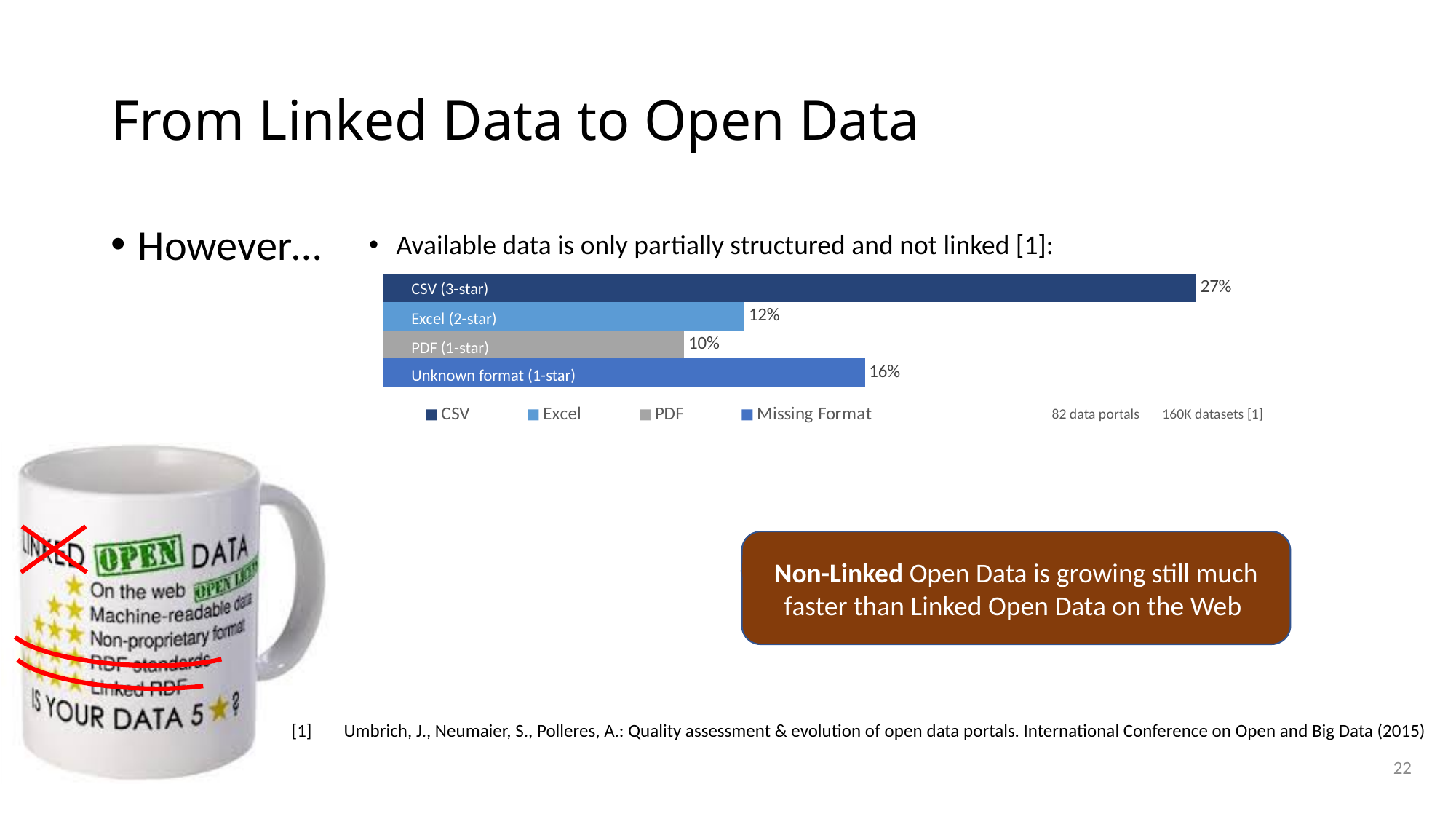
What is the value for CSV (3-star)? 27% How many entries does the legend list? 4 What kind of chart is shown on the slide? Bar chart What is the value for Excel (2-star)? 12% Which category has the highest value? CSV (3-star) Which category has the lowest value? PDF (1-star) What is the value for PDF (1-star)? 10% How many bars does the chart show? 4 Which is larger, the value for Excel (2-star) or the value for Unknown format (1-star)? Unknown format (1-star) What is the value for Unknown format (1-star)? 16% What is the difference between the values for CSV (3-star) and Unknown format (1-star)? 11% What is the difference between the values for Excel (2-star) and PDF (1-star)? 2%